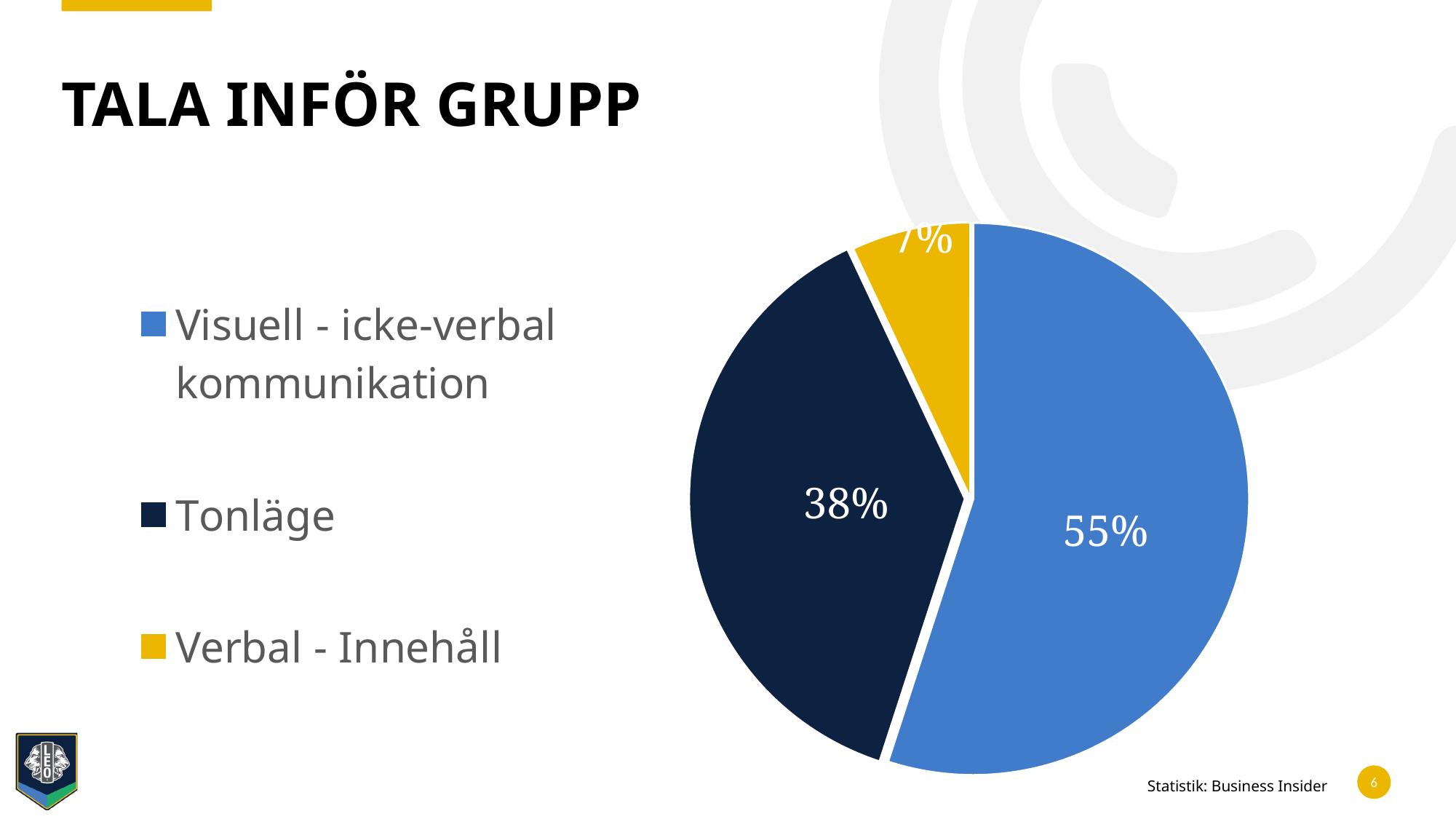
Which category has the largest slice of the pie? Visuell - icke-verbal kommunikation What is the title of the slide containing the pie chart? TALA INFÖR GRUPP Which is larger, the slice for "Tonläge" or the slice for "Verbal - Innehåll"? Tonläge What share of the pie does "Visuell - icke-verbal kommunikation" have? 55% What kind of chart is shown on the slide? pie chart How many categories does the pie chart have? 3 What share of the pie does "Tonläge" have? 38% Which category has the smallest slice of the pie? Verbal - Innehåll What colour is the slice for "Tonläge"? dark navy blue What share of the pie does "Verbal - Innehåll" have? 7% What is the difference in percentage points between "Visuell - icke-verbal kommunikation" and "Tonläge"? 17% What is the difference in percentage points between "Tonläge" and "Verbal - Innehåll"? 31%